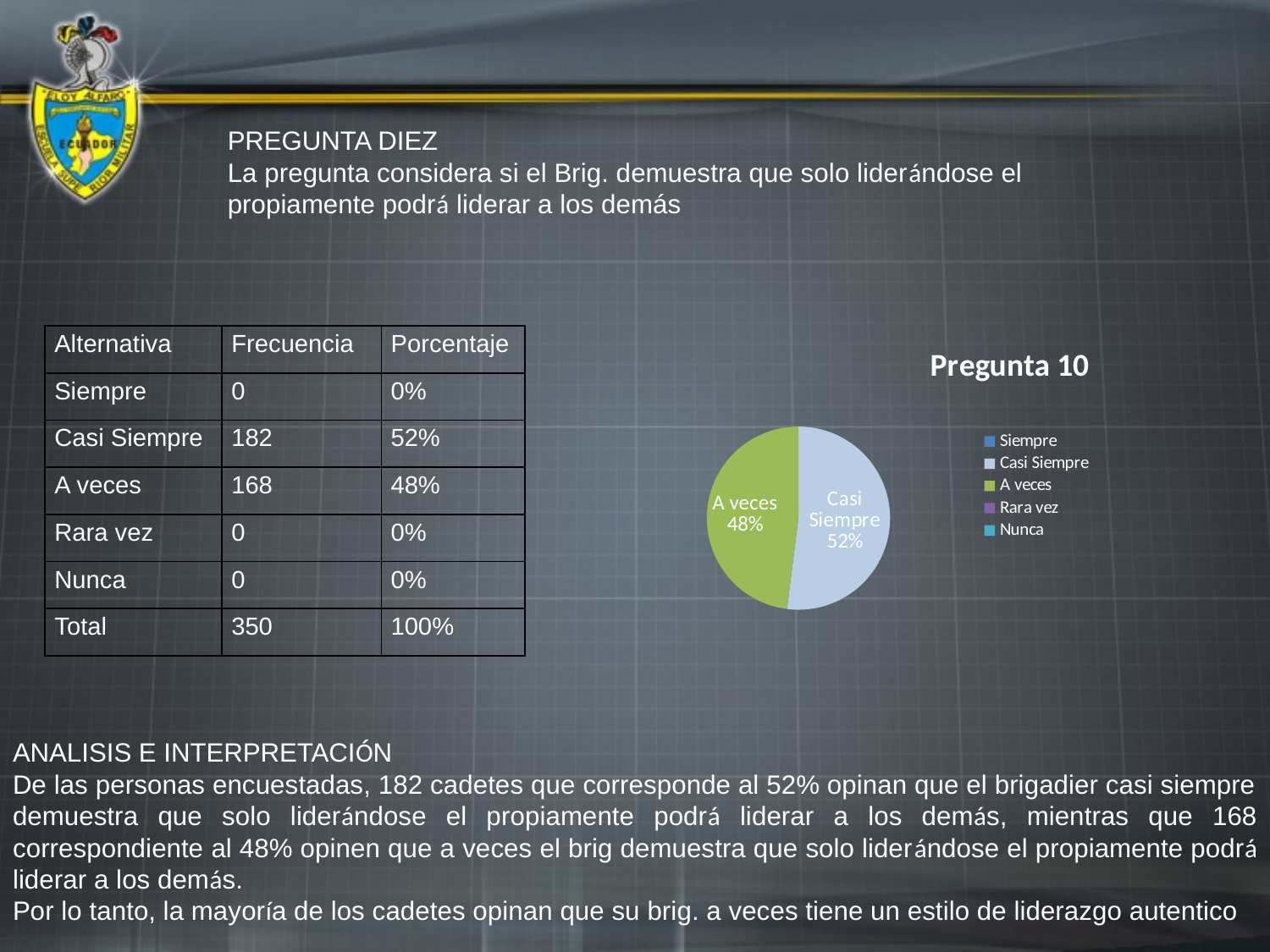
What type of chart is shown on the slide? pie chart Which legend entry is shown in green in the pie chart? A veces What is the title of the chart? Pregunta 10 What share of the pie does the A veces slice represent? 48% How many entries does the chart legend list? 5 Which category has the largest slice in the pie chart? Casi Siempre What percentage does the chart show for A veces? 48% How many slices are visibly labelled in the pie chart? 2 What percentage does the chart show for Casi Siempre? 52% Is the value for Casi Siempre greater or less than 50%? greater Which is larger in the pie chart, Casi Siempre or A veces? Casi Siempre What is the difference in percentage points between the Casi Siempre and A veces slices? 4